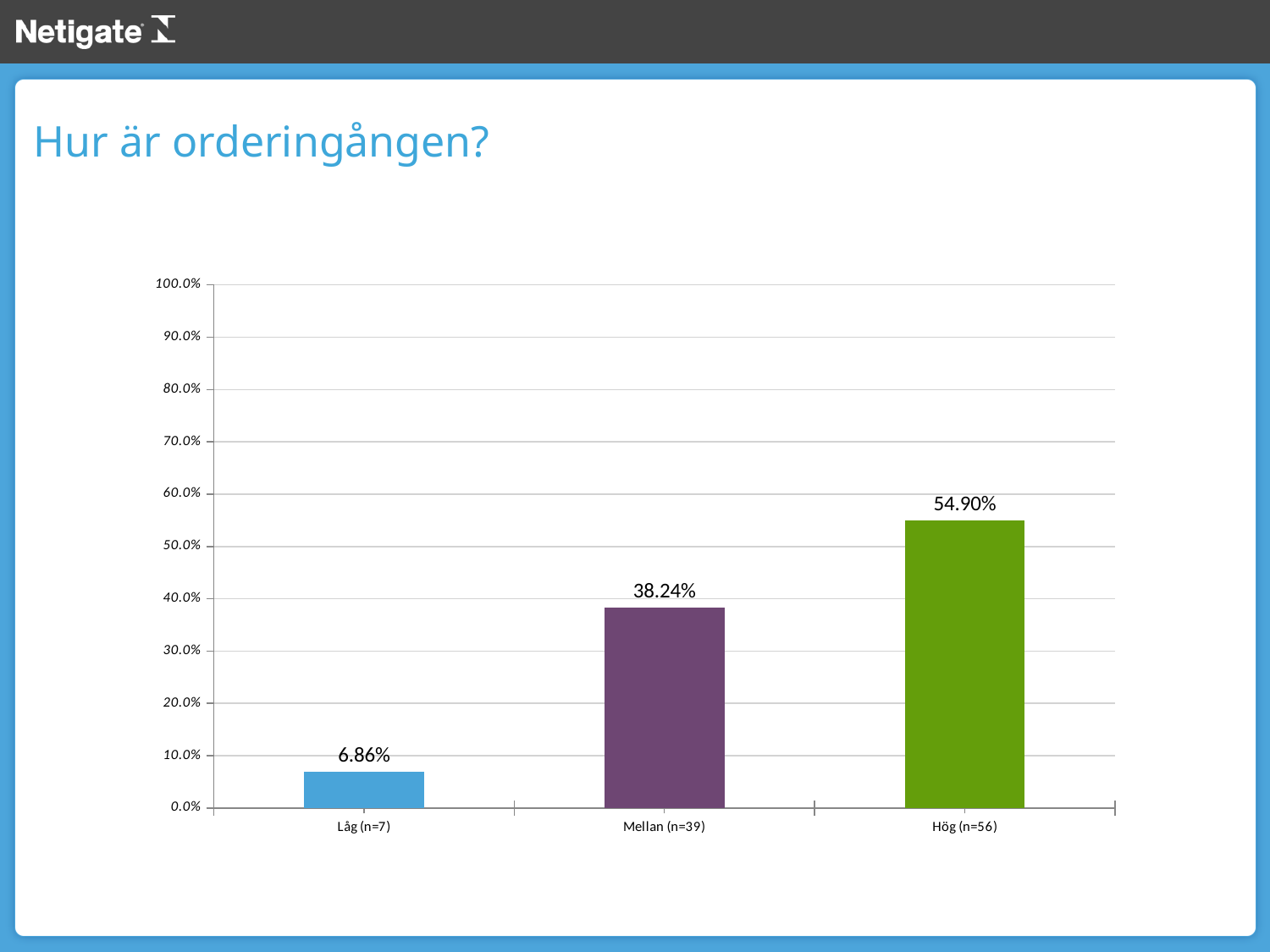
What kind of chart is shown on the slide? bar chart What is the difference between the values for Mellan (n=39) and Låg (n=7)? 31.38% What is the value for Låg (n=7)? 6.86% Which is larger, the value for Mellan (n=39) or the value for Låg (n=7)? Mellan (n=39) Which category has the highest value? Hög (n=56) How many categories are shown on the x axis? 3 Do the values rise or fall from left to right along the x axis? rise What is the difference between the values for Hög (n=56) and Mellan (n=39)? 16.66% What is the value for Hög (n=56)? 54.90% Is the value for Hög (n=56) greater or less than 50.0%? greater Which category has the lowest value? Låg (n=7) What is the value for Mellan (n=39)? 38.24%